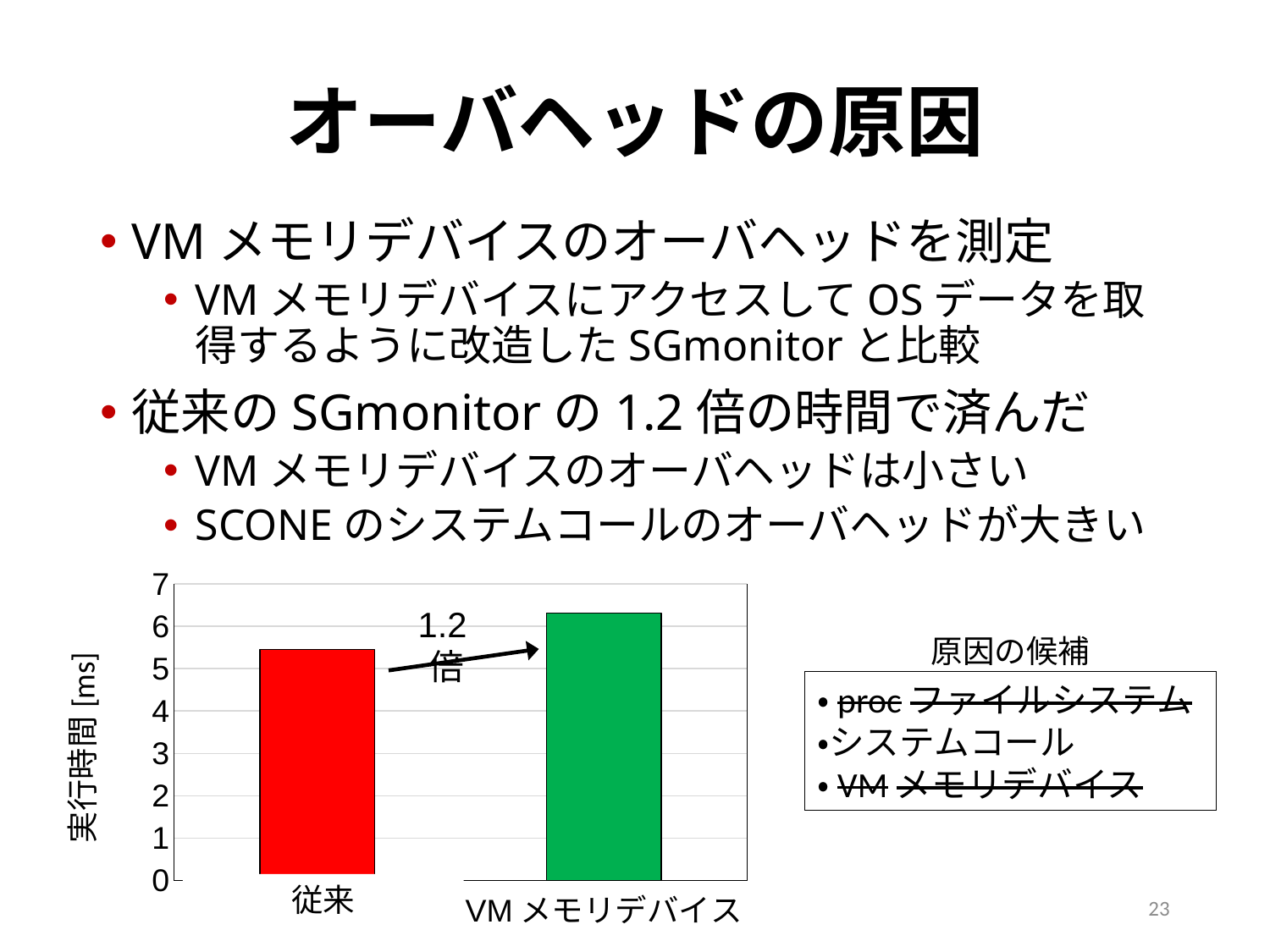
Which category has the lowest 実行時間? 従来 What ratio does the arrow annotation between the two bars indicate? 1.2倍 Is the value for 従来 greater or less than 5? greater Is the value for 従来 greater or less than 6? less What is the label of the y axis of the chart? 実行時間 [ms] Do the values rise or fall from 従来 to VM メモリデバイス along the x axis? rise Is the value for VM メモリデバイス greater or less than 7? less Which category has the highest 実行時間? VM メモリデバイス Which is larger, the value for 従来 or the value for VM メモリデバイス? VM メモリデバイス How many bars (categories) does the chart show? 2 What kind of chart is shown on the slide? bar chart